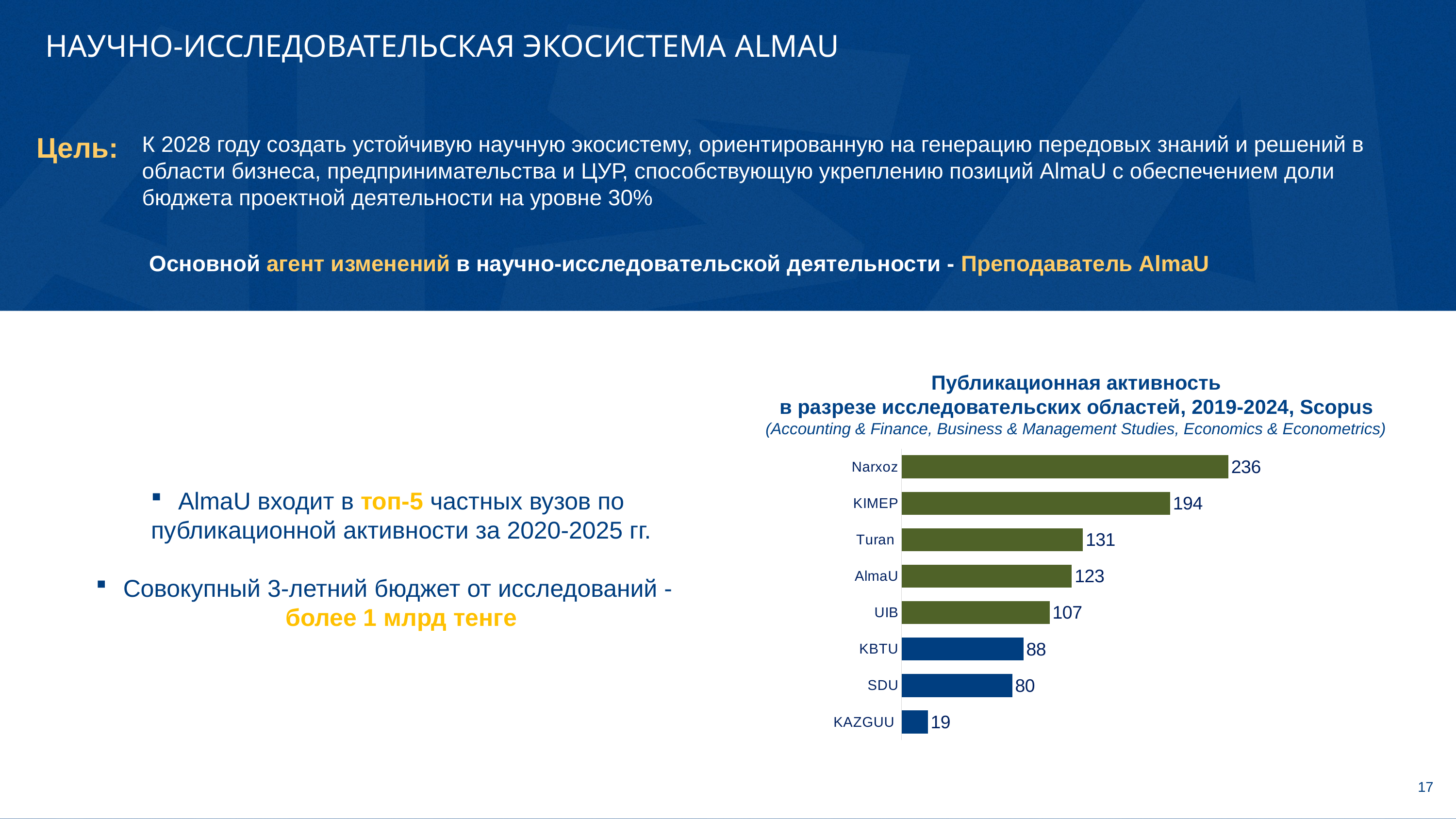
What is the value for AlmaU? 123 What database is named in the chart title? Scopus What is the difference between the values for Narxoz and KIMEP? 42 What is the value for Narxoz? 236 How many bars are coloured green? 5 Which is larger, the value for UIB or the value for SDU? UIB What is the difference between the values for Turan and AlmaU? 8 How many universities are shown in the chart? 8 Which university has the highest value? Narxoz Which university has the lowest value? KAZGUU What is the value for KBTU? 88 What kind of chart is shown? Bar chart